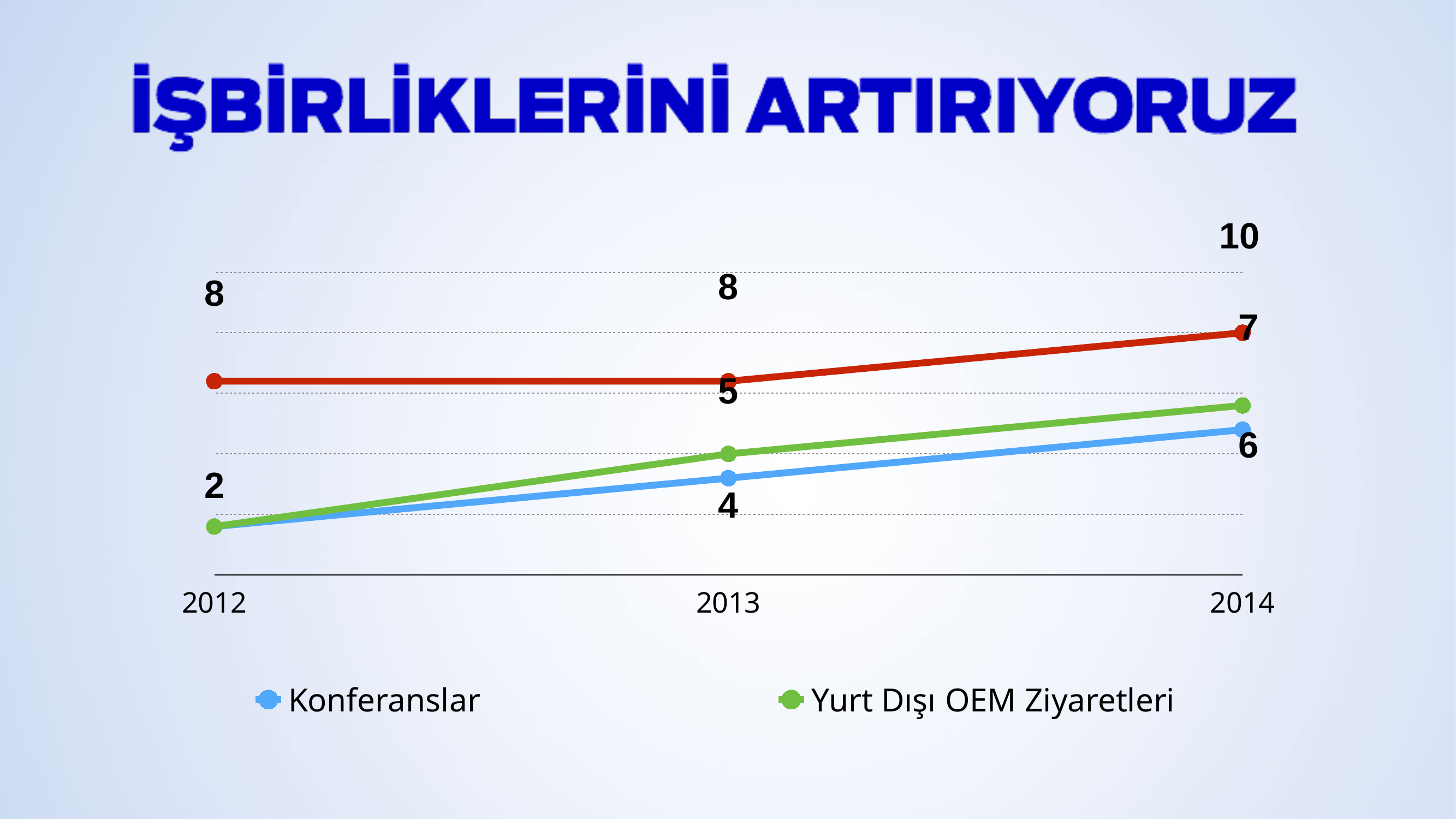
In 2014, which is larger: Konferanslar or Yurt Dışı OEM Ziyaretleri? Yurt Dışı OEM Ziyaretleri How many years are shown on the x axis? 3 What kind of chart is shown on the slide? line chart What is the value for Konferanslar in 2012? 2 What is the value for Yurt Dışı OEM Ziyaretleri in 2013? 5 By how much did Konferanslar increase from 2013 to 2014? 2 What is the value for Konferanslar in 2014? 6 What is the value for Yurt Dışı OEM Ziyaretleri in 2014? 7 Does the Konferanslar line rise or fall from 2012 to 2014? rise By how much did Yurt Dışı OEM Ziyaretleri increase from 2012 to 2014? 5 How many series does the legend list? 2 What is the value for Konferanslar in 2013? 4